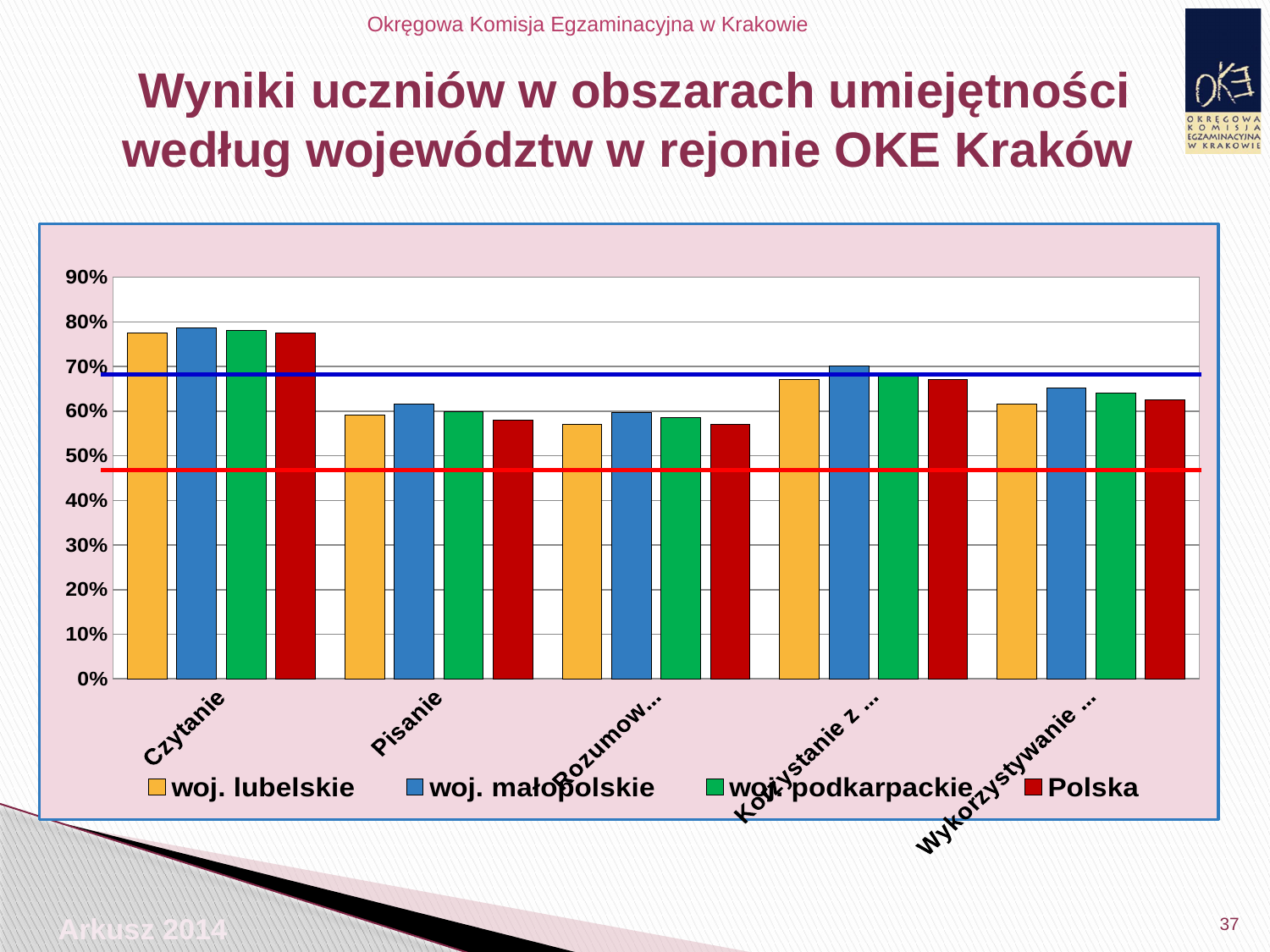
Is the value for Polska in Czytanie greater or less than 70%? greater Which series is listed first in the legend? woj. lubelskie What kind of chart is shown on the slide? bar chart How many series does the legend list? 4 How many categories are shown on the x axis? 5 Which colour represents Polska in the legend? red Is the value for Polska in Pisanie greater or less than 70%? less Which is larger for woj. lubelskie: the value in Czytanie or the value in Pisanie? Czytanie Is the value for woj. lubelskie in Czytanie greater or less than 70%? greater Which category has the highest values across all series? Czytanie